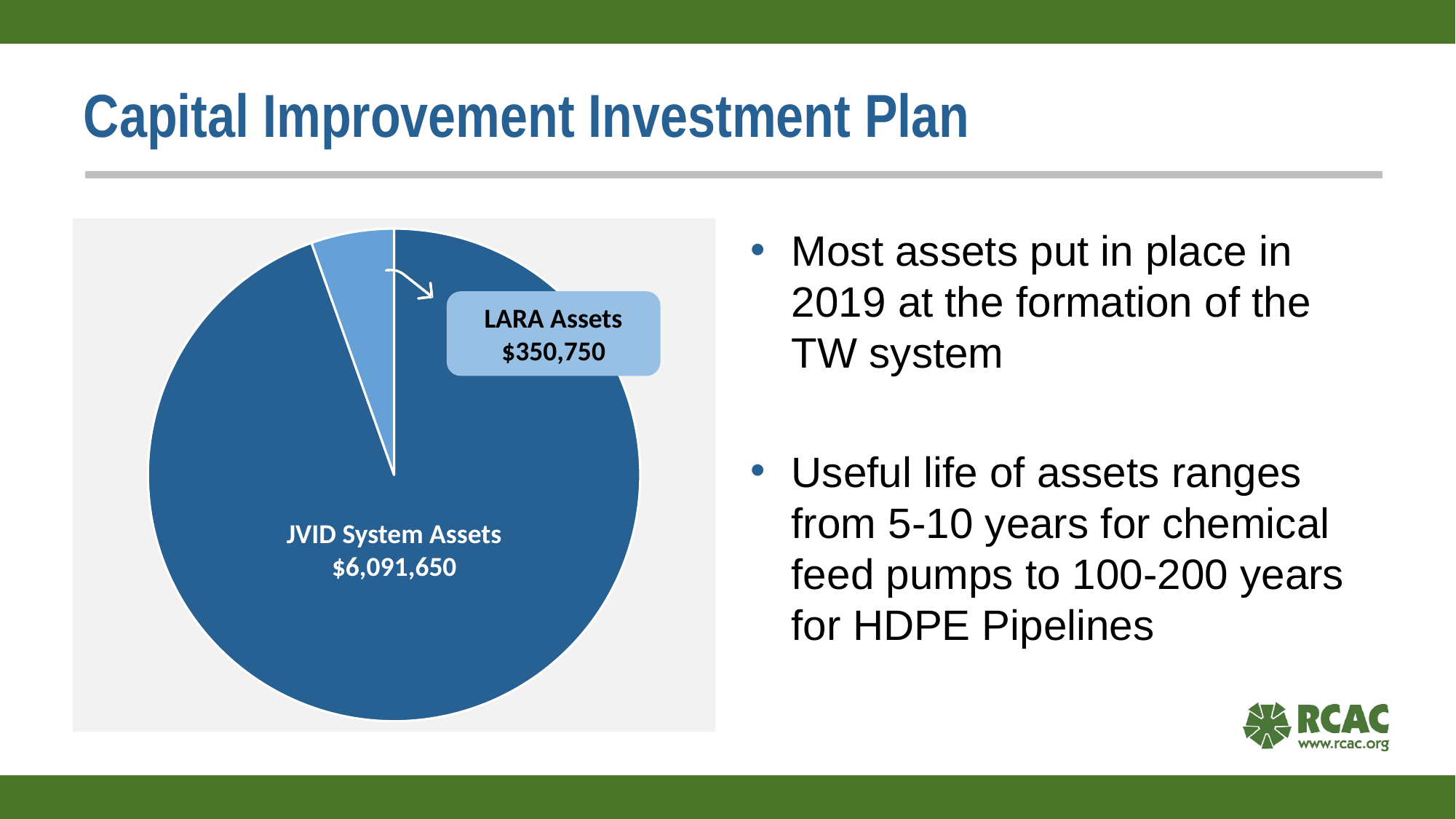
What is the value shown for LARA Assets in the pie chart? $350,750 How many slices does the pie chart have? 2 Which category has the largest slice of the pie chart? JVID System Assets What is the value shown for JVID System Assets in the pie chart? $6,091,650 What is the difference between the JVID System Assets value and the LARA Assets value? $5,740,900 What colour is the LARA Assets slice in the pie chart? Light blue Which is larger, JVID System Assets or LARA Assets? JVID System Assets Which category has the smallest slice of the pie chart? LARA Assets What type of chart is shown on the slide? Pie chart What is the combined total of the two slices in the pie chart? $6,442,400